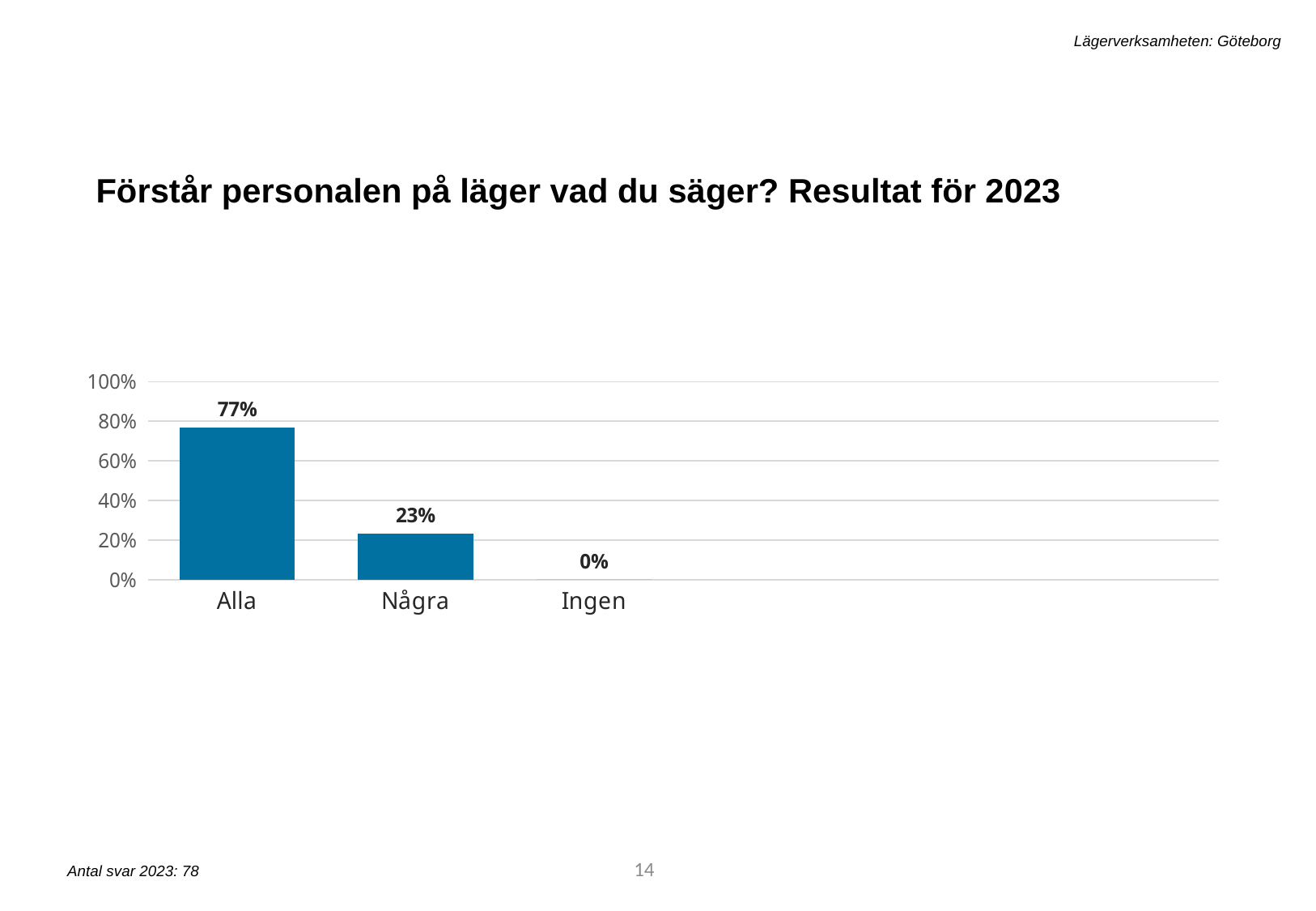
Which category has the lowest value? Ingen Is the value for Alla greater or less than 60%? greater What is the difference between the values for Alla and Några? 54% Which category has the highest value? Alla Is the value for Några greater or less than 40%? less What is the value for Några? 23% What is the title of the slide above the chart? Förstår personalen på läger vad du säger? Resultat för 2023 How many categories are shown on the x axis? 3 What kind of chart is shown on the slide? bar chart What is the value for Ingen? 0% What is the value for Alla? 77% Which is larger, the value for Alla or the value for Några? Alla